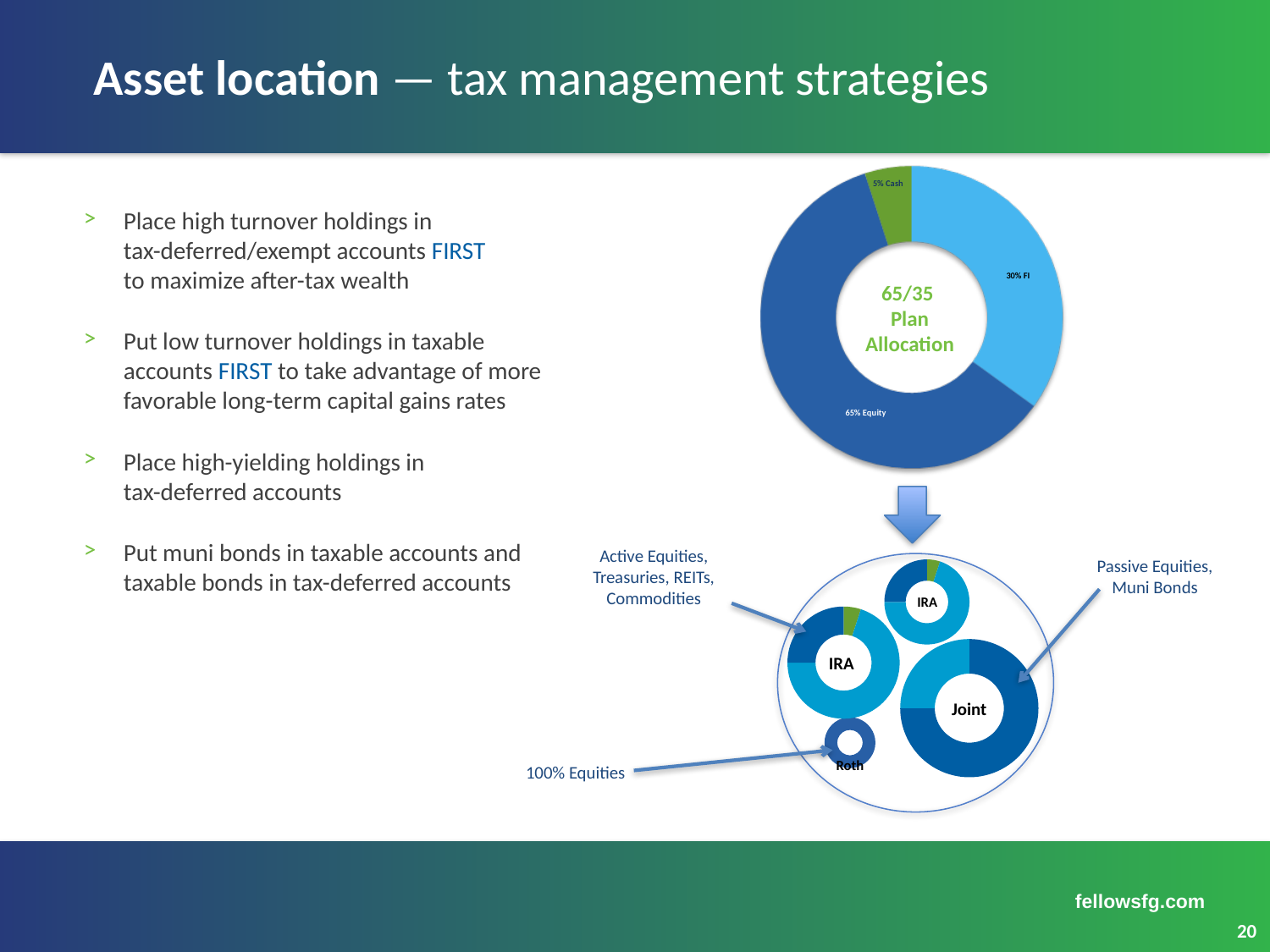
In the 65/35 Plan Allocation chart, what share is labeled for Equity? 65% How many slices does the 65/35 Plan Allocation chart have? 3 How many small donut charts are shown inside the circle below the large donut chart? 4 In the 65/35 Plan Allocation chart, how much larger is the Equity share than the FI share? 35% In the 65/35 Plan Allocation chart, which is larger, the FI slice or the Cash slice? FI In the 65/35 Plan Allocation chart, what share is labeled for Cash? 5% In the 65/35 Plan Allocation chart, what do the three labeled shares add up to? 100% In the 65/35 Plan Allocation chart, what share is labeled for FI? 30% What text appears in the center of the large donut chart? 65/35 Plan Allocation In the 65/35 Plan Allocation chart, which slice is the smallest? Cash What kind of chart is the 65/35 Plan Allocation chart? Donut (pie) chart In the 65/35 Plan Allocation chart, which slice is the largest? Equity